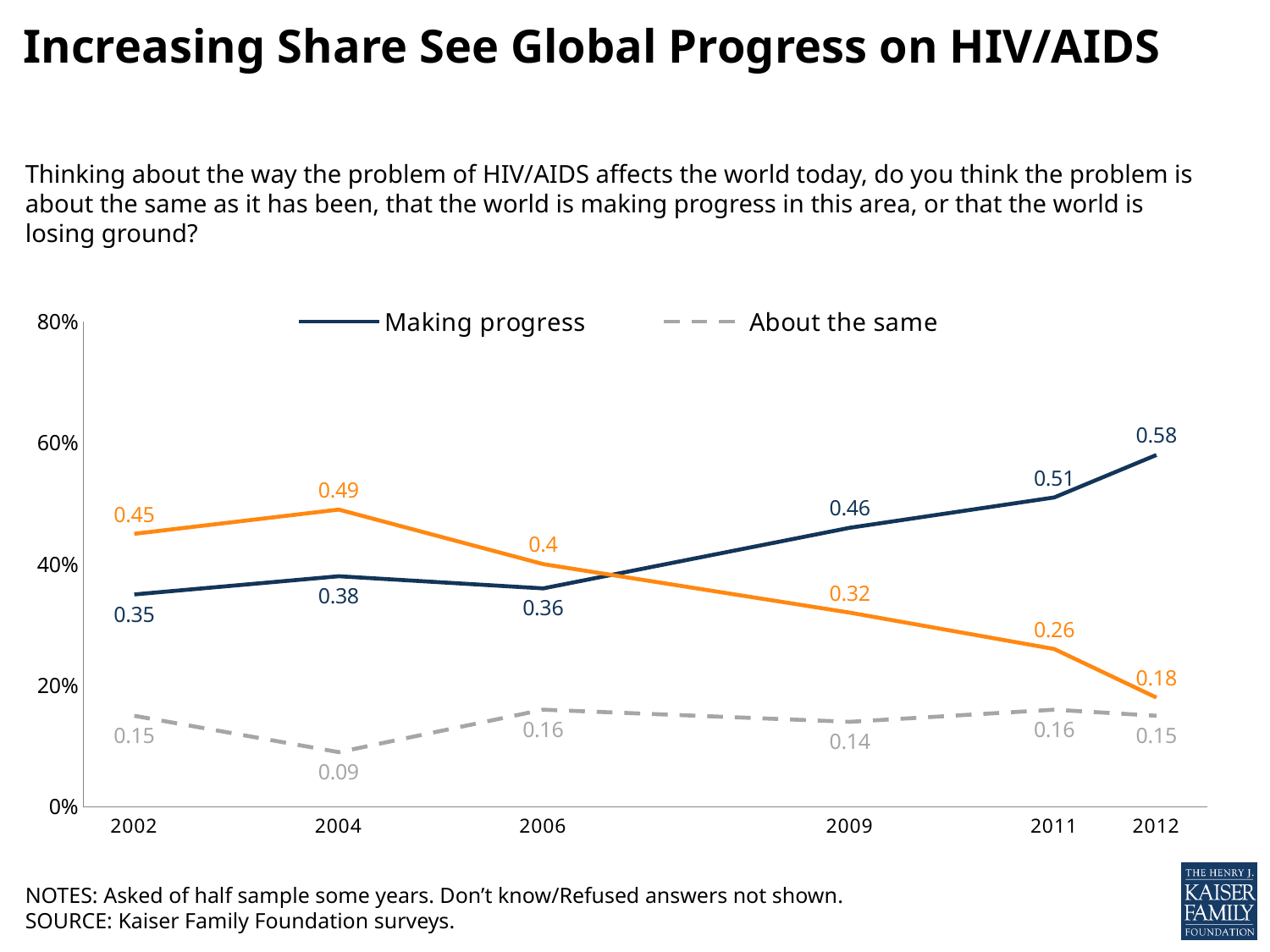
What is the value for Making progress in 2012? 0.58 Which is larger, the Making progress value in 2011 or in 2006? 2011 In which year is the About the same series lowest? 2004 Does the Making progress series rise or fall from 2006 to 2012? rise What is the value for Making progress in 2009? 0.46 Is the value for Making progress in 2012 greater or less than 40%? greater How many years are plotted on the x axis? 6 What is the difference between the Making progress values in 2012 and 2002? 0.23 How many series does the legend list? 2 What is the value for About the same in 2004? 0.09 In which year is the Making progress series highest? 2012 What kind of chart is shown on the slide? line chart